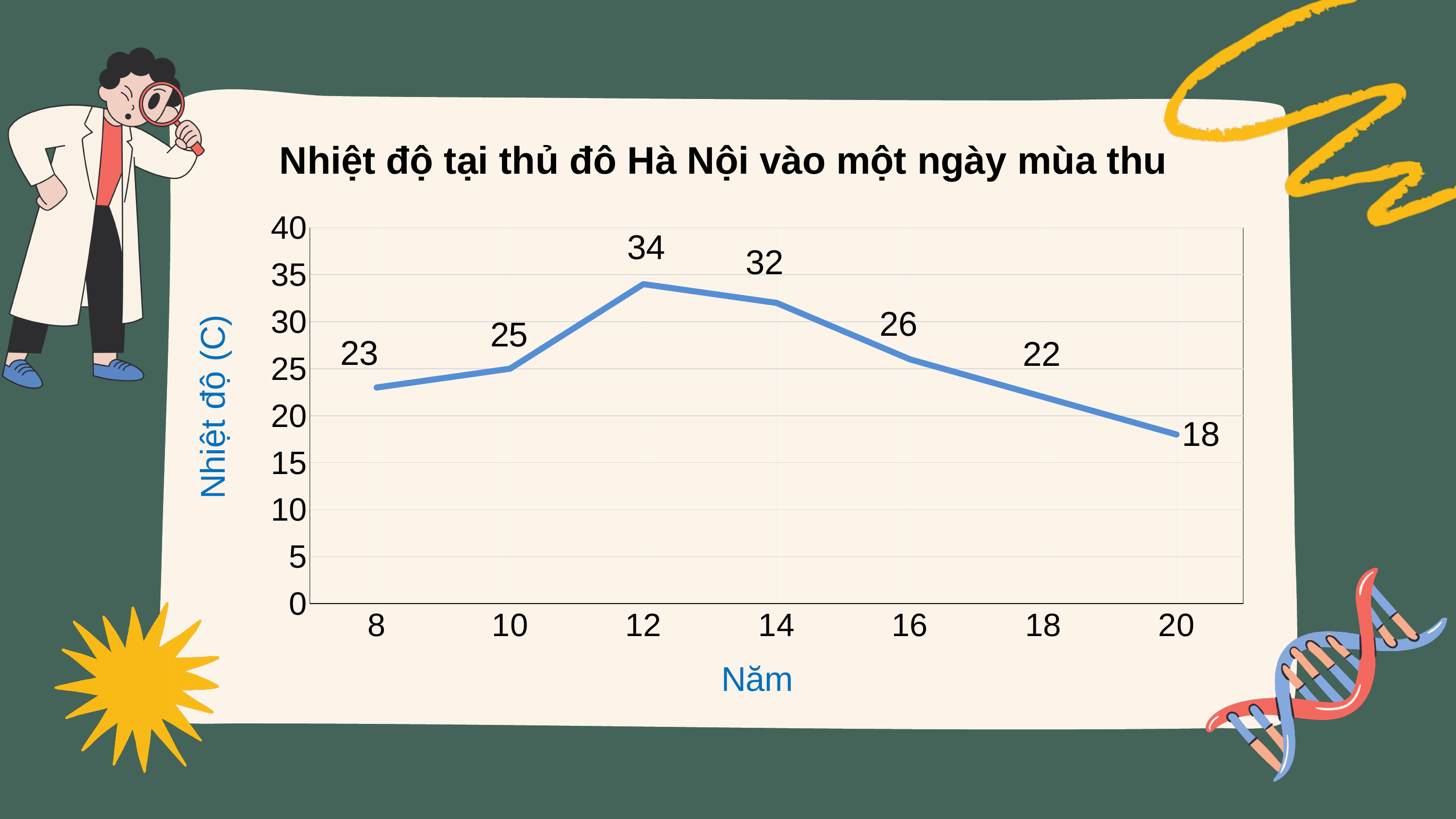
What is the title of the chart? Nhiệt độ tại thủ đô Hà Nội vào một ngày mùa thu Do the values rise or fall between 12 and 20 on the x axis? fall How many data points are plotted on the line? 7 What kind of chart is shown on the slide? line chart What is the temperature at 12 on the x axis? 34 What is the difference between the temperature at 12 and the temperature at 20? 16 What is the difference between the temperature at 14 and the temperature at 16? 6 What is the temperature at 20 on the x axis? 18 At which x-axis value is the temperature highest? 12 Which is larger, the temperature at 10 or the temperature at 18? 10 At which x-axis value is the temperature lowest? 20 What is the temperature at 8 on the x axis? 23